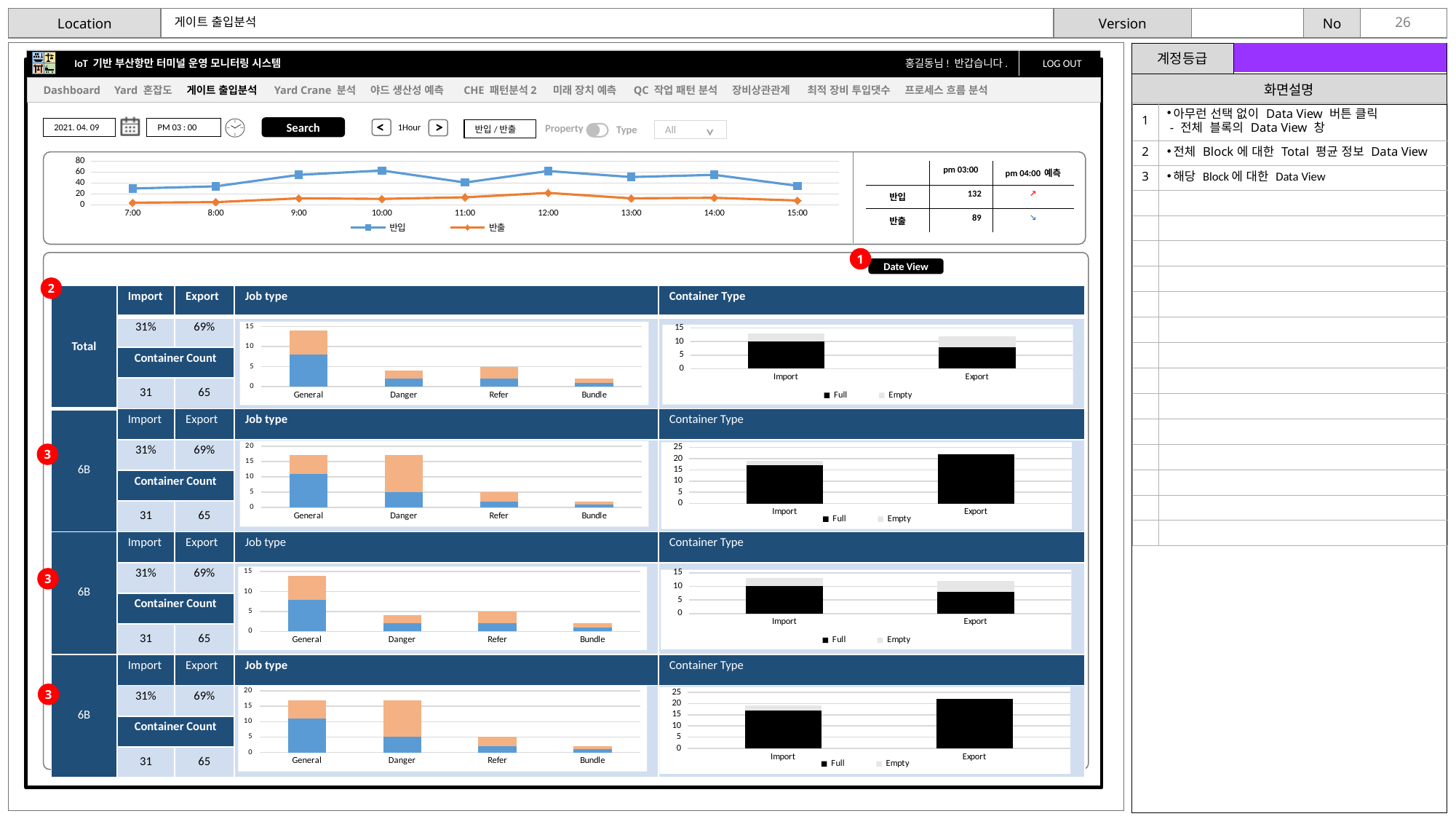
In the Job type chart in the Total row, which category has the tallest bar? General In the line chart at the top of the slide, at which time is the 반출 series highest? 12:00 In the line chart at the top of the slide, which series has the larger value at 12:00, 반입 or 반출? 반입 In the line chart at the top of the slide, how many series does the legend list? 2 In the Job type chart in the Total row, which category has the shortest bar? Bundle In the Job type chart in the Total row, is the total for General greater or less than 10? greater What kind of chart is the Job type chart in the Total row? Stacked bar chart In the Job type chart in the Total row, how many categories are shown on the x axis? 4 In the Container Type chart in the first 6B row (second row of the table), which bar is taller, Import or Export? Export In the line chart at the top of the slide, is the 반입 value at 10:00 greater or less than 40? greater In the line chart at the top of the slide, is the 반출 value at 7:00 greater or less than 20? less In the line chart at the top of the slide, how many time points are plotted along the x axis? 9